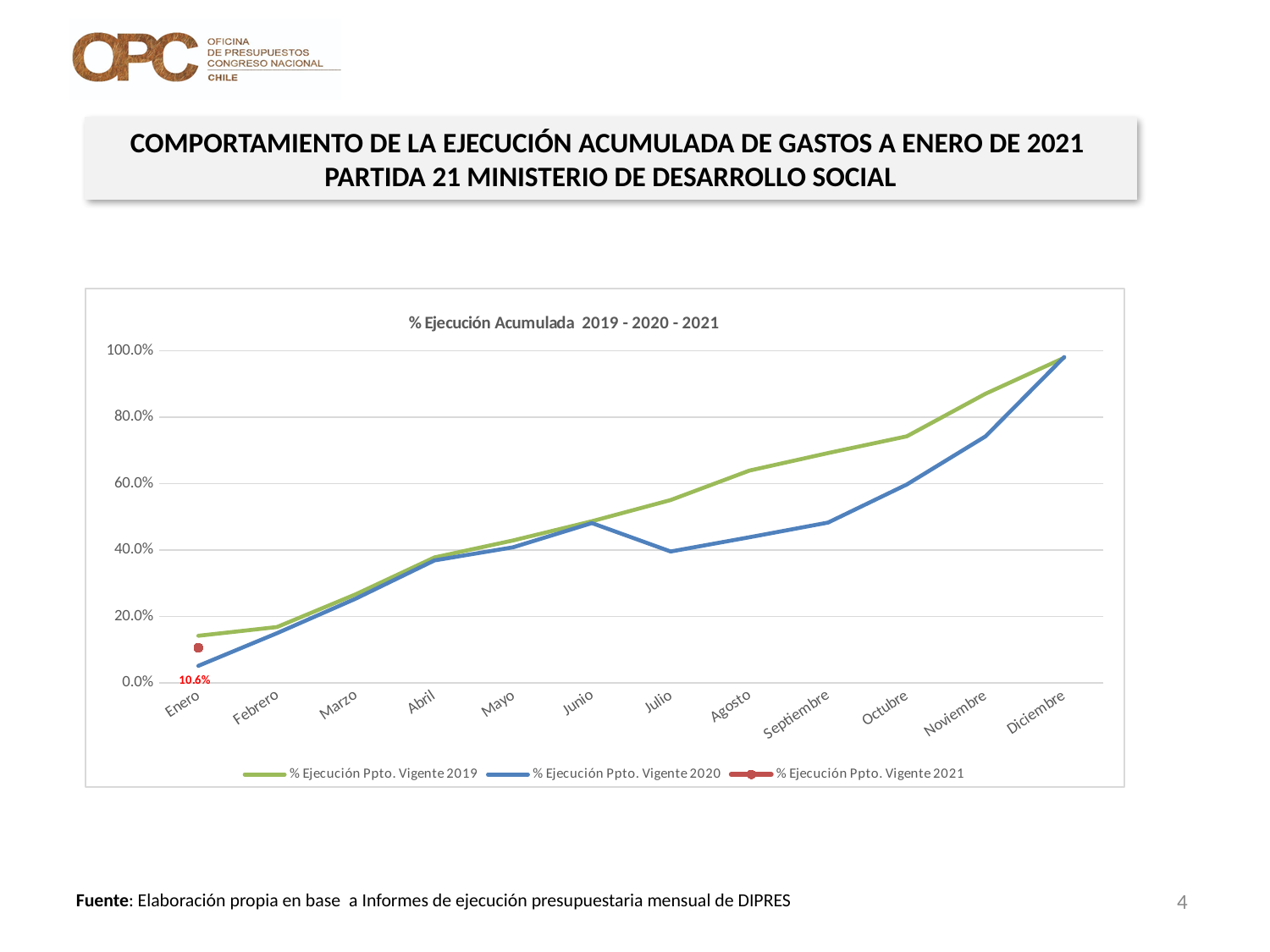
Is the value for % Ejecución Ppto. Vigente 2020 in Enero greater or less than 20.0%? less Is the value for % Ejecución Ppto. Vigente 2019 in Diciembre greater or less than 80.0%? greater In which month does the % Ejecución Ppto. Vigente 2020 series reach its highest value? Diciembre How many months are shown along the x axis of the chart? 12 What is the value of % Ejecución Ppto. Vigente 2021 for Enero? 10.6% Is the value for % Ejecución Ppto. Vigente 2020 in Septiembre greater or less than 60.0%? less In Julio, which series has the higher value: % Ejecución Ppto. Vigente 2019 or % Ejecución Ppto. Vigente 2020? % Ejecución Ppto. Vigente 2019 How many series does the chart legend list? 3 What kind of chart is shown on the slide? line chart What is the title of the chart? % Ejecución Acumulada 2019 - 2020 - 2021 Does the % Ejecución Ppto. Vigente 2019 series rise or fall from Enero to Diciembre? rise In which month does the % Ejecución Ppto. Vigente 2019 series have its lowest value? Enero